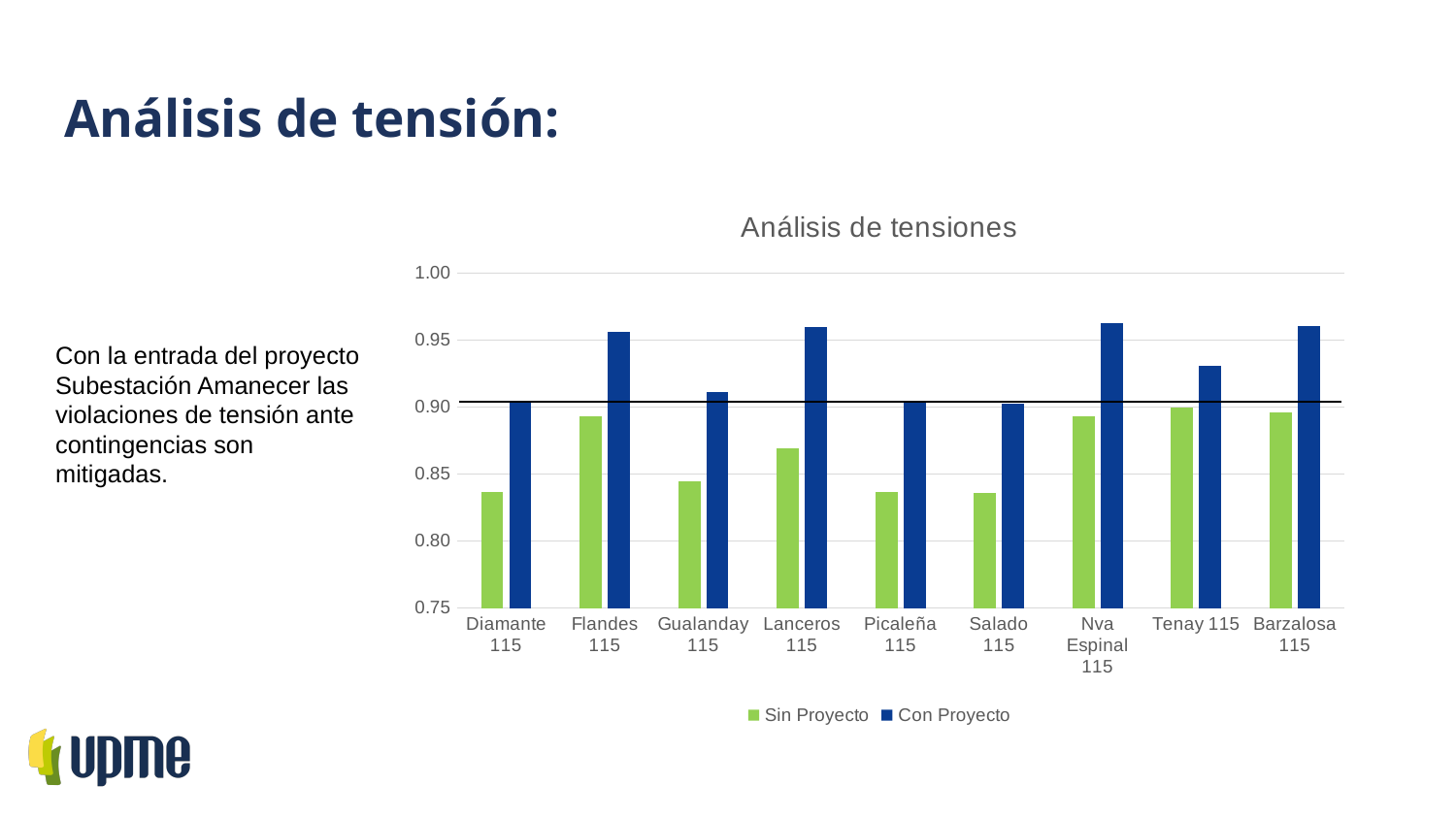
How many categories (substations) are shown on the x axis of the chart? 9 How many series does the chart legend list? 2 Is the 'Sin Proyecto' value for Lanceros 115 greater or less than 0.85? greater Is the 'Sin Proyecto' value for Diamante 115 greater or less than 0.85? less Is the 'Con Proyecto' value for Flandes 115 greater or less than 0.95? greater Which is larger: the 'Con Proyecto' value for Flandes 115 or for Tenay 115? Flandes 115 Which colour represents the 'Con Proyecto' series in the chart? Blue Which is larger: the 'Sin Proyecto' value for Lanceros 115 or for Gualanday 115? Lanceros 115 What is the title of the chart? Análisis de tensiones What kind of chart is shown on the slide? Bar chart